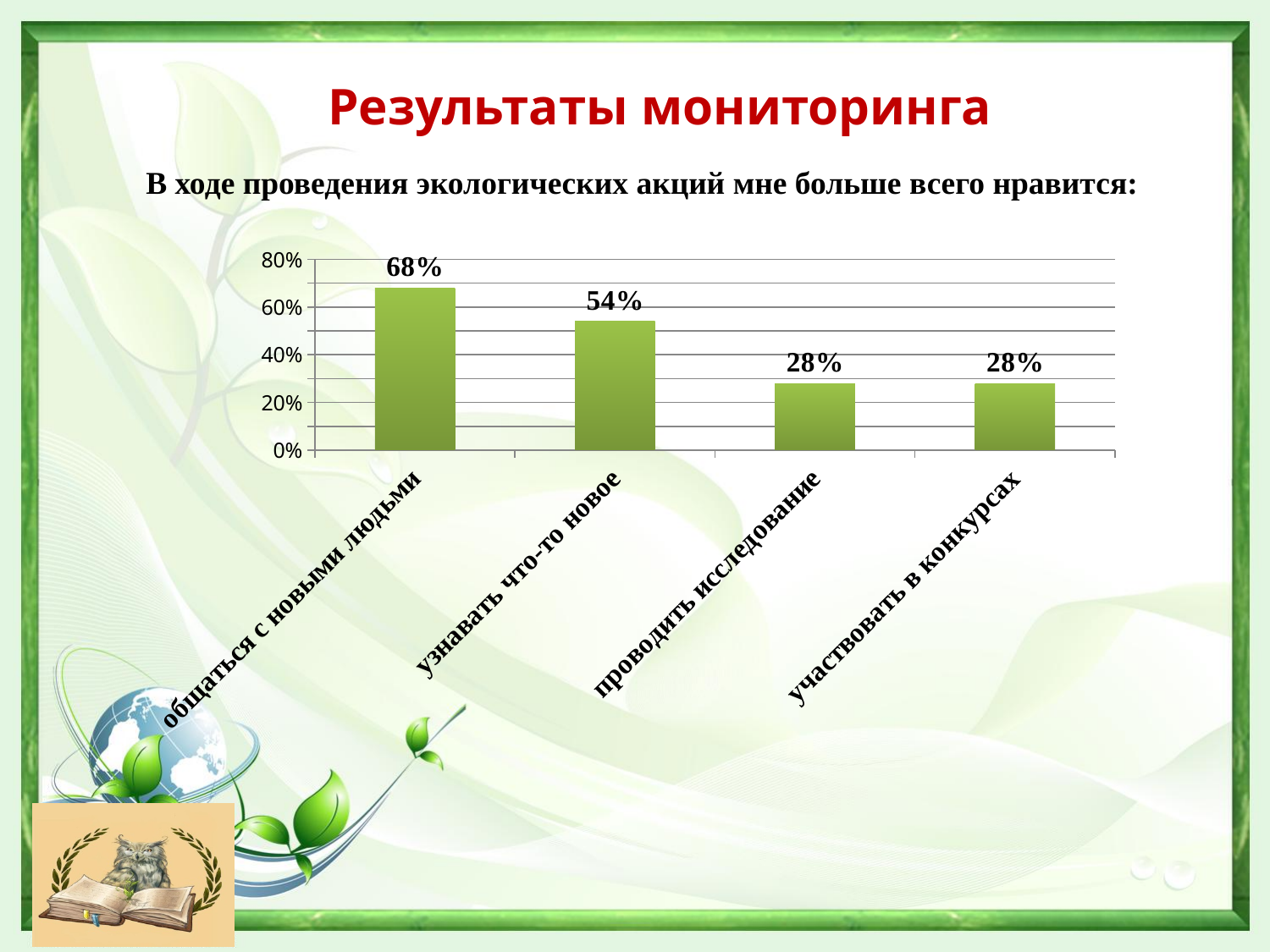
What is the value for "общаться с новыми людьми"? 68% What kind of chart is shown on the slide? bar chart Do the values rise or fall from left to right across the categories? fall What is the value for "проводить исследование"? 28% What is the difference between the values for "общаться с новыми людьми" and "узнавать что-то новое"? 14% How many categories are shown in the chart? 4 What is the value for "участвовать в конкурсах"? 28% Is the value for "общаться с новыми людьми" greater or less than 60%? greater Which category has the highest value? общаться с новыми людьми Which is larger, the value for "узнавать что-то новое" or the value for "участвовать в конкурсах"? узнавать что-то новое What is the difference between the values for "узнавать что-то новое" and "проводить исследование"? 26% What is the value for "узнавать что-то новое"? 54%